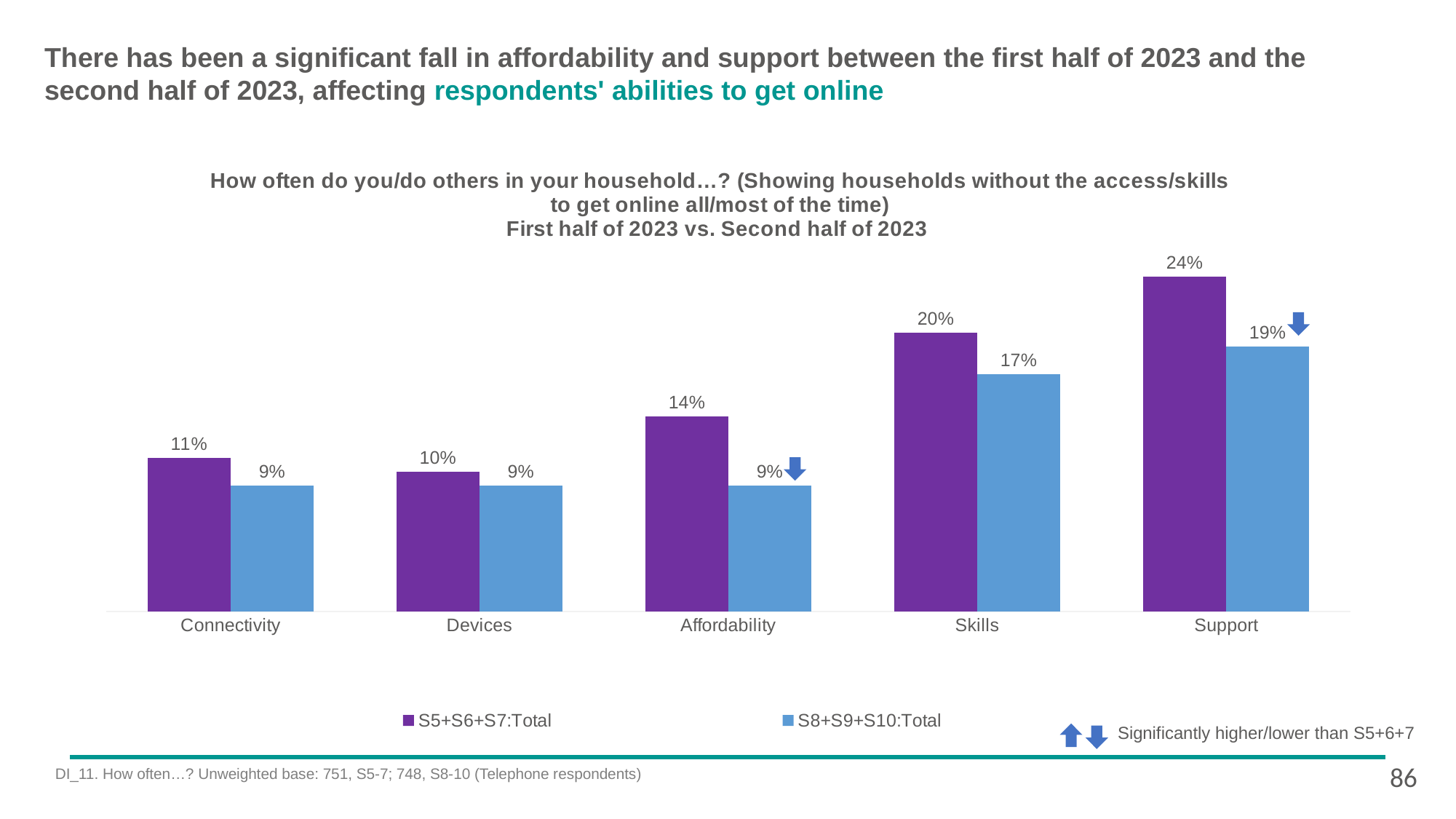
What is the difference between the S5+S6+S7:Total and S8+S9+S10:Total values for Support? 5% What is the value for Devices in the S5+S6+S7:Total series? 10% What is the value for Skills in the S8+S9+S10:Total series? 17% Which is larger for Skills: the S5+S6+S7:Total value or the S8+S9+S10:Total value? S5+S6+S7:Total What kind of chart is shown on the slide? Bar chart Which category has the lowest value in the S5+S6+S7:Total series? Devices What is the value for Affordability in the S8+S9+S10:Total series? 9% How many categories are shown on the x axis? 5 What is the difference between the S5+S6+S7:Total and S8+S9+S10:Total values for Affordability? 5% What is the value for Support in the S5+S6+S7:Total series? 24% Which category has the highest value in the S5+S6+S7:Total series? Support How many series does the legend list? 2